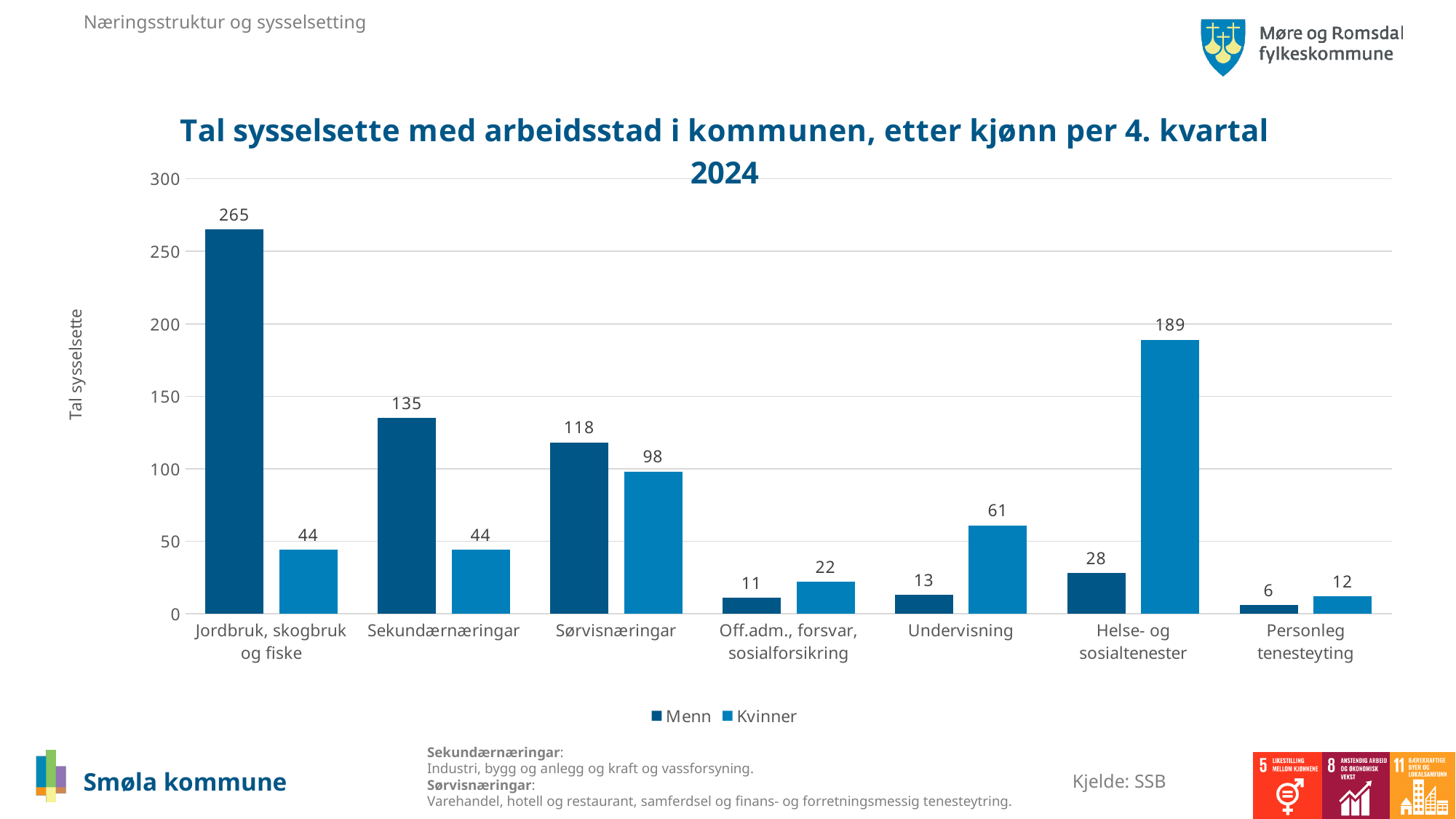
How many series does the legend list? 2 Is the value for Kvinner in Helse- og sosialtenester greater or less than 150? greater What is the difference between Menn and Kvinner in Sekundærnæringar? 91 Which category has the lowest value for Kvinner? Personleg tenesteyting Which is larger in Undervisning, Menn or Kvinner? Kvinner What is the label of the vertical axis? Tal sysselsette Which category has the highest value for Menn? Jordbruk, skogbruk og fiske What kind of chart is shown on the slide? Bar chart What is the value for Menn in Jordbruk, skogbruk og fiske? 265 How many categories are shown on the x axis? 7 What is the value for Kvinner in Helse- og sosialtenester? 189 What is the value for Kvinner in Sørvisnæringar? 98